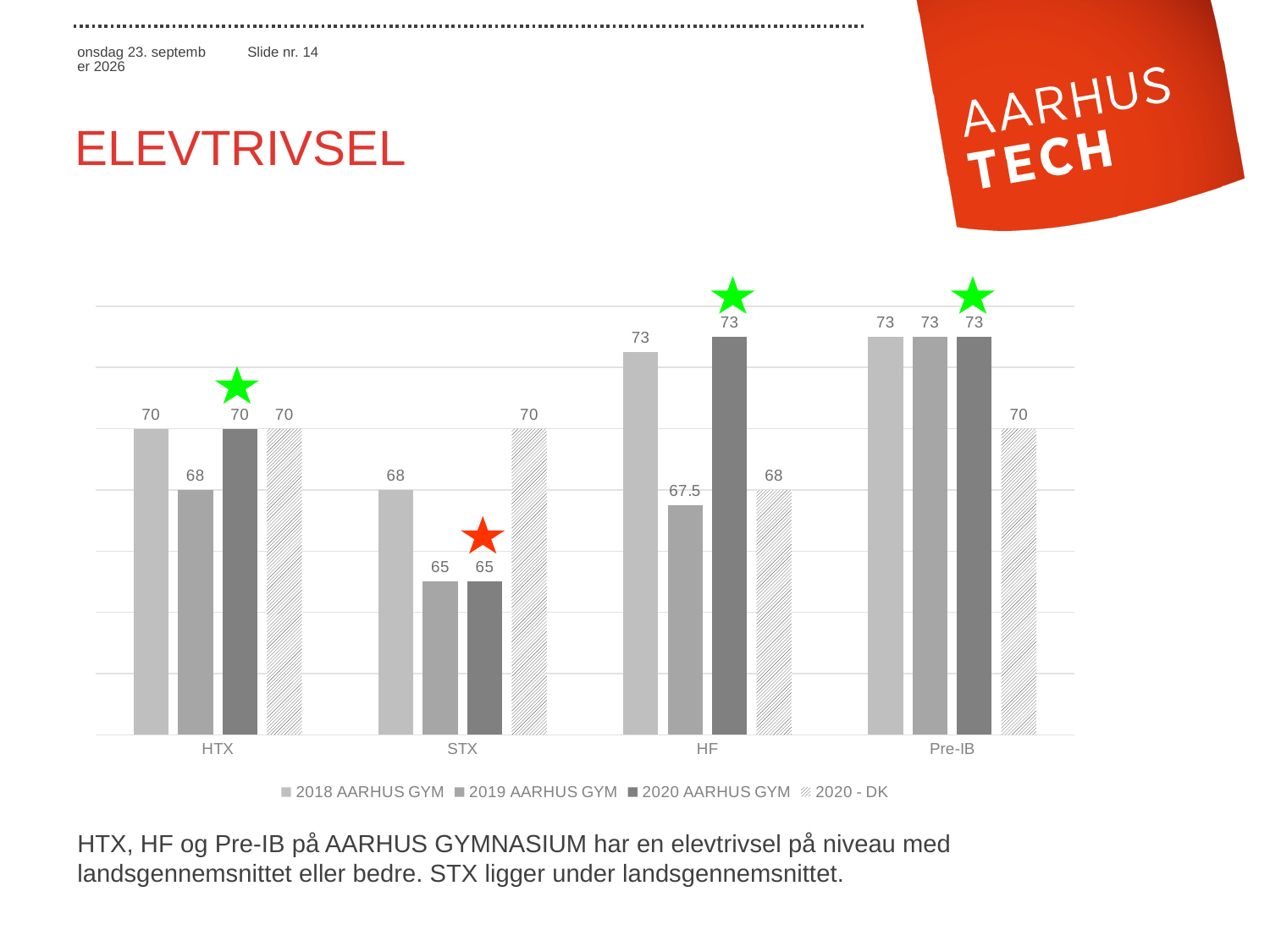
For HF, which is larger: the 2020 AARHUS GYM value or the 2020 - DK value? 2020 AARHUS GYM How many series does the legend list? 4 What is the 2020 - DK value for HF? 68 Which category has the lowest value in the 2020 AARHUS GYM series? STX What is the 2020 AARHUS GYM value for Pre-IB? 73 What kind of chart is shown on the slide? Bar chart What is the value for STX in the 2019 AARHUS GYM series? 65 How many categories are shown on the x axis? 4 What is the difference between the 2020 AARHUS GYM value and the 2020 - DK value for STX? 5 Which category has the highest value in the 2019 AARHUS GYM series? Pre-IB What is the value for HF in the 2019 AARHUS GYM series? 67.5 Which series in the legend is drawn with a hatched pattern? 2020 - DK